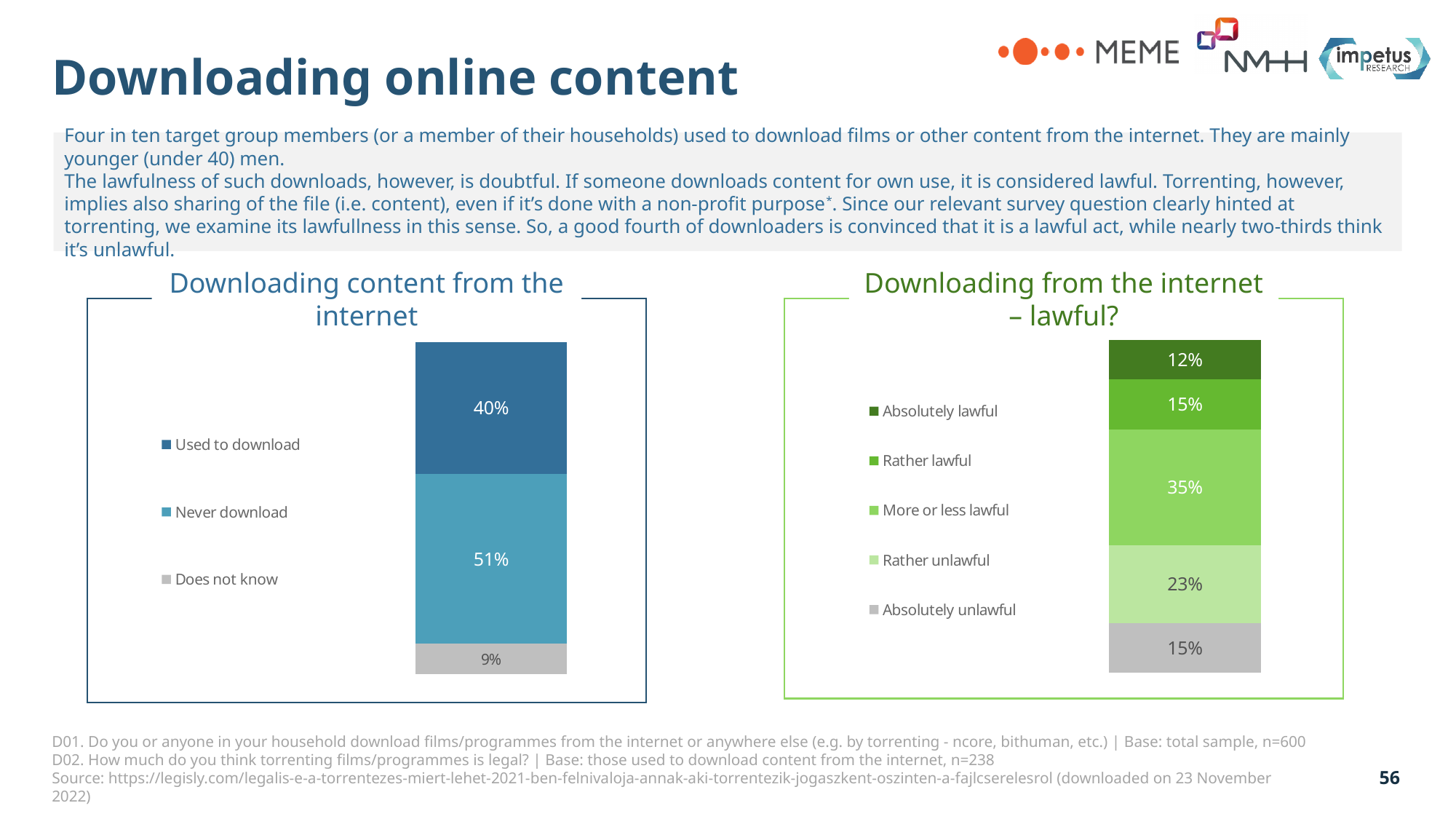
In the 'Downloading content from the internet' chart, which category has the largest share? Never download What kind of chart is the 'Downloading content from the internet' chart? Stacked bar chart In the 'Downloading from the internet – lawful?' chart, what percentage is shown for 'More or less lawful'? 35% In the 'Downloading content from the internet' chart, what percentage is shown for 'Does not know'? 9% In the 'Downloading from the internet – lawful?' chart, what percentage is shown for 'Rather unlawful'? 23% In the 'Downloading content from the internet' chart, what percentage is shown for 'Never download'? 51% In the 'Downloading from the internet – lawful?' chart, which is larger: 'Rather unlawful' or 'Rather lawful'? Rather unlawful In the 'Downloading from the internet – lawful?' chart, what percentage is shown for 'Absolutely lawful'? 12% In the 'Downloading from the internet – lawful?' chart, which category has the smallest share? Absolutely lawful How many series does the legend of the 'Downloading from the internet – lawful?' chart list? 5 In the 'Downloading content from the internet' chart, what percentage is shown for 'Used to download'? 40% In the 'Downloading content from the internet' chart, what is the difference between 'Never download' and 'Used to download'? 11%